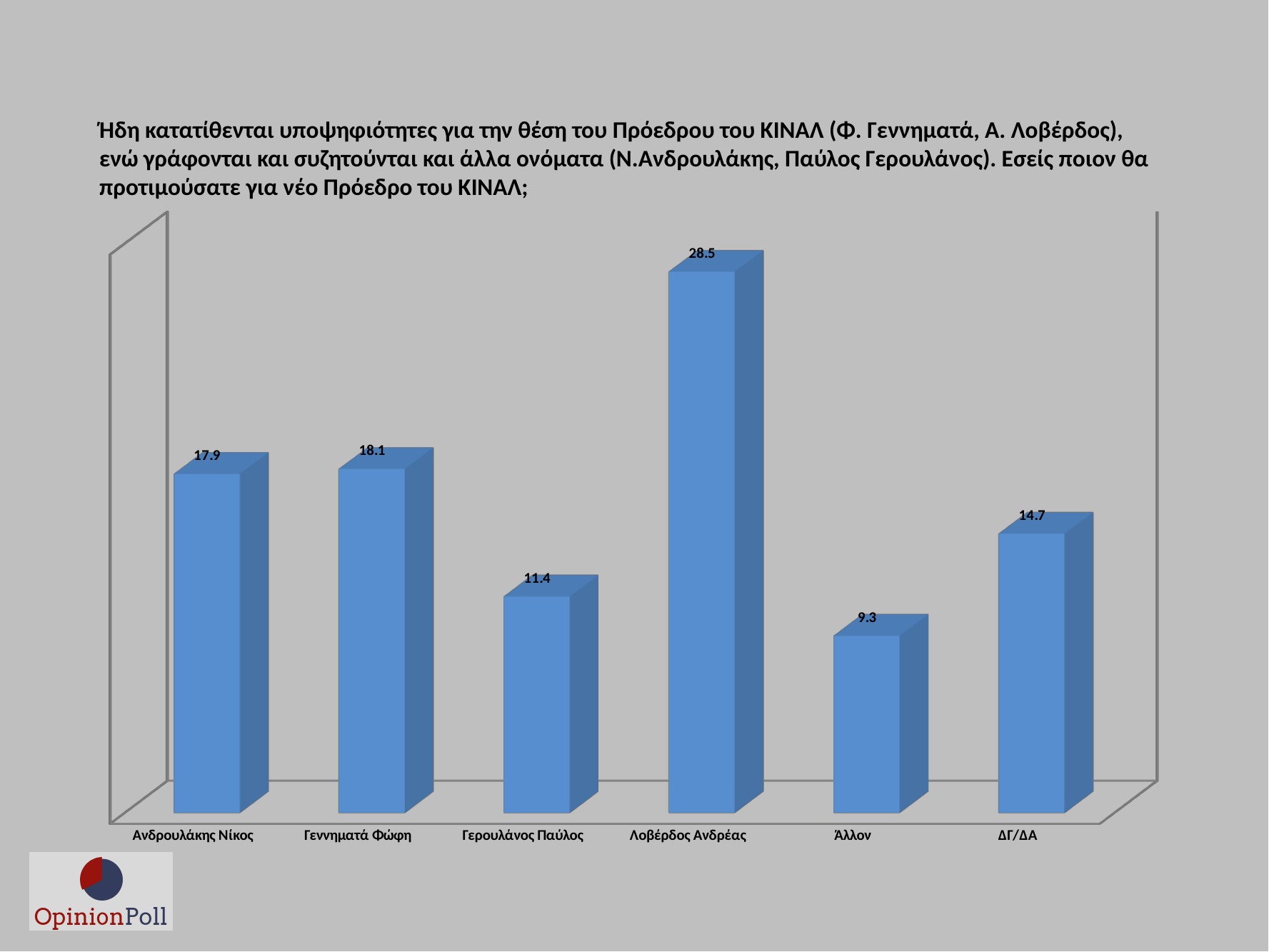
Which is larger, the value for Γερουλάνος Παύλος or the value for ΔΓ/ΔΑ? ΔΓ/ΔΑ Which category has the lowest value? Άλλον What is the difference between the values for Γερουλάνος Παύλος and Άλλον? 2.1 What is the difference between the values for Λοβέρδος Ανδρέας and Γεννηματά Φώφη? 10.4 What value is shown for Ανδρουλάκης Νίκος? 17.9 What value is shown for Άλλον? 9.3 What value is shown for ΔΓ/ΔΑ? 14.7 What value is shown for Λοβέρδος Ανδρέας? 28.5 How many categories are shown on the chart? 6 Which category has the highest value? Λοβέρδος Ανδρέας What kind of chart is shown on the slide? Bar chart What value is shown for Γεννηματά Φώφη? 18.1